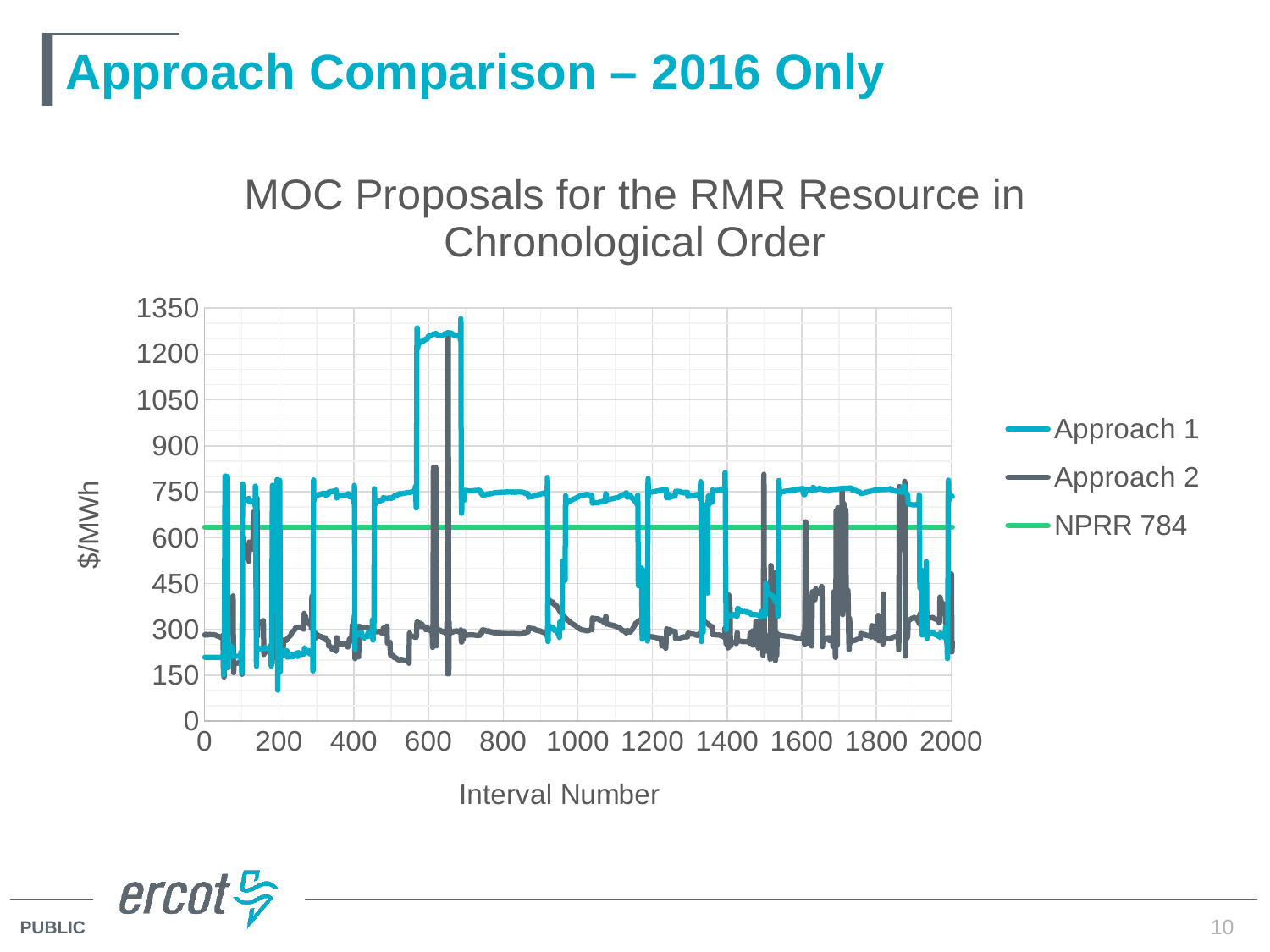
Is the value of the NPRR 784 line greater or less than 600? greater What is the label of the vertical axis? $/MWh What is the highest tick value shown on the vertical axis? 1350 How many series does the legend list? 3 Is the value of the NPRR 784 line greater or less than 750? less Which series stays constant across all interval numbers? NPRR 784 Which series reaches the highest value on the chart? Approach 1 What is the title of the chart? MOC Proposals for the RMR Resource in Chronological Order What kind of chart is shown on the slide? Line chart Around interval 1000, which series has the larger value, Approach 1 or Approach 2? Approach 1 Is the peak value of Approach 1 around interval 600 greater or less than 1200? greater